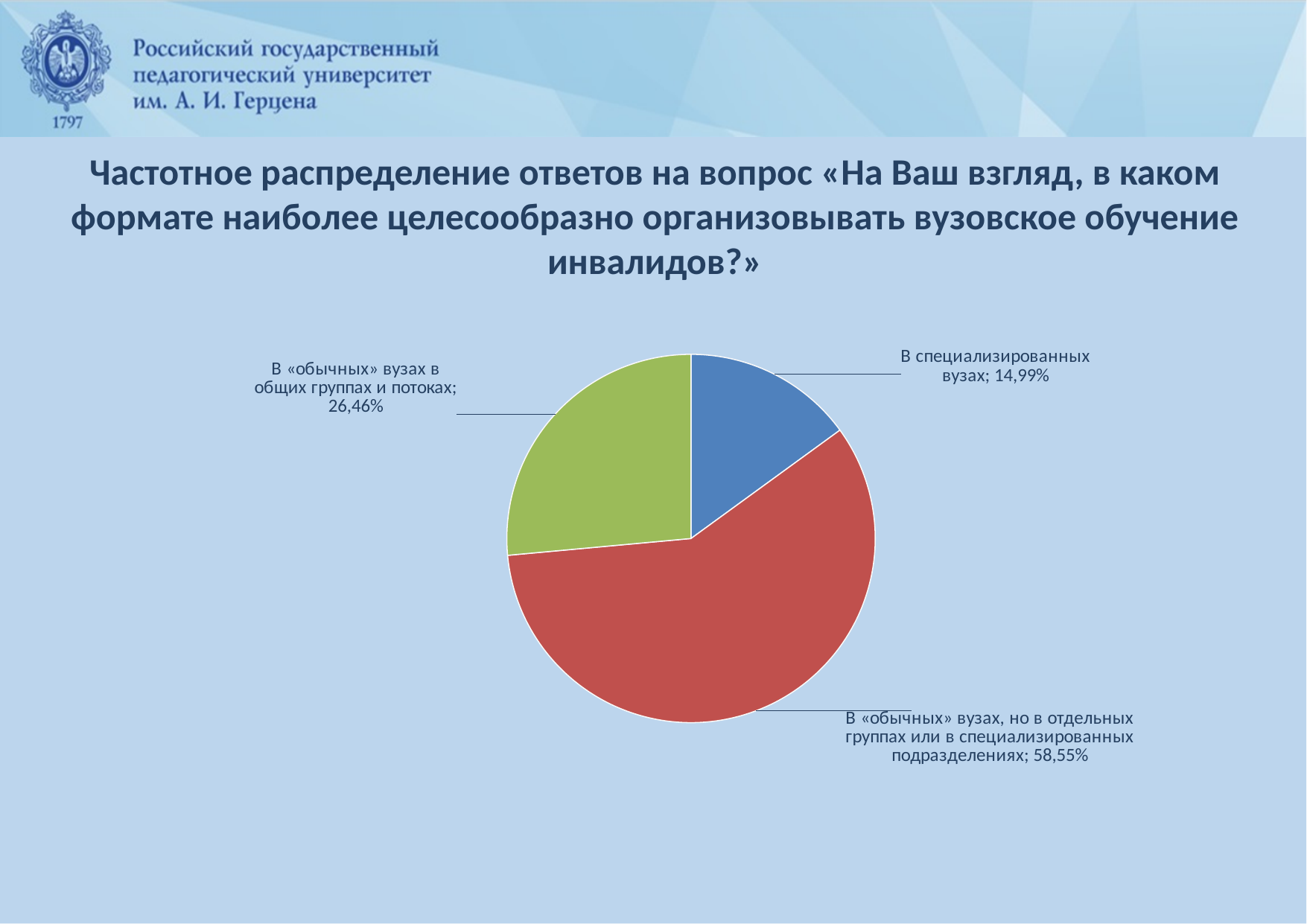
What share of responses is for «В «обычных» вузах, но в отдельных группах или в специализированных подразделениях»? 58,55% What kind of chart is shown on the slide? Pie chart What is the difference in percentage points between the share for «В «обычных» вузах в общих группах и потоках» and the share for «В специализированных вузах»? 11,47 What share of responses is for «В специализированных вузах»? 14,99% Which is larger: the share for «В «обычных» вузах в общих группах и потоках» or the share for «В специализированных вузах»? В «обычных» вузах в общих группах и потоках How many slices does the pie chart have? 3 What colour is the slice for «В специализированных вузах»? Blue What share of responses is for «В «обычных» вузах в общих группах и потоках»? 26,46% Which answer option has the largest share of the pie? В «обычных» вузах, но в отдельных группах или в специализированных подразделениях Which answer option has the smallest share of the pie? В специализированных вузах What colour is the largest slice of the pie? Red What is the difference in percentage points between the share for «В «обычных» вузах, но в отдельных группах или в специализированных подразделениях» and the share for «В «обычных» вузах в общих группах и потоках»? 32,09